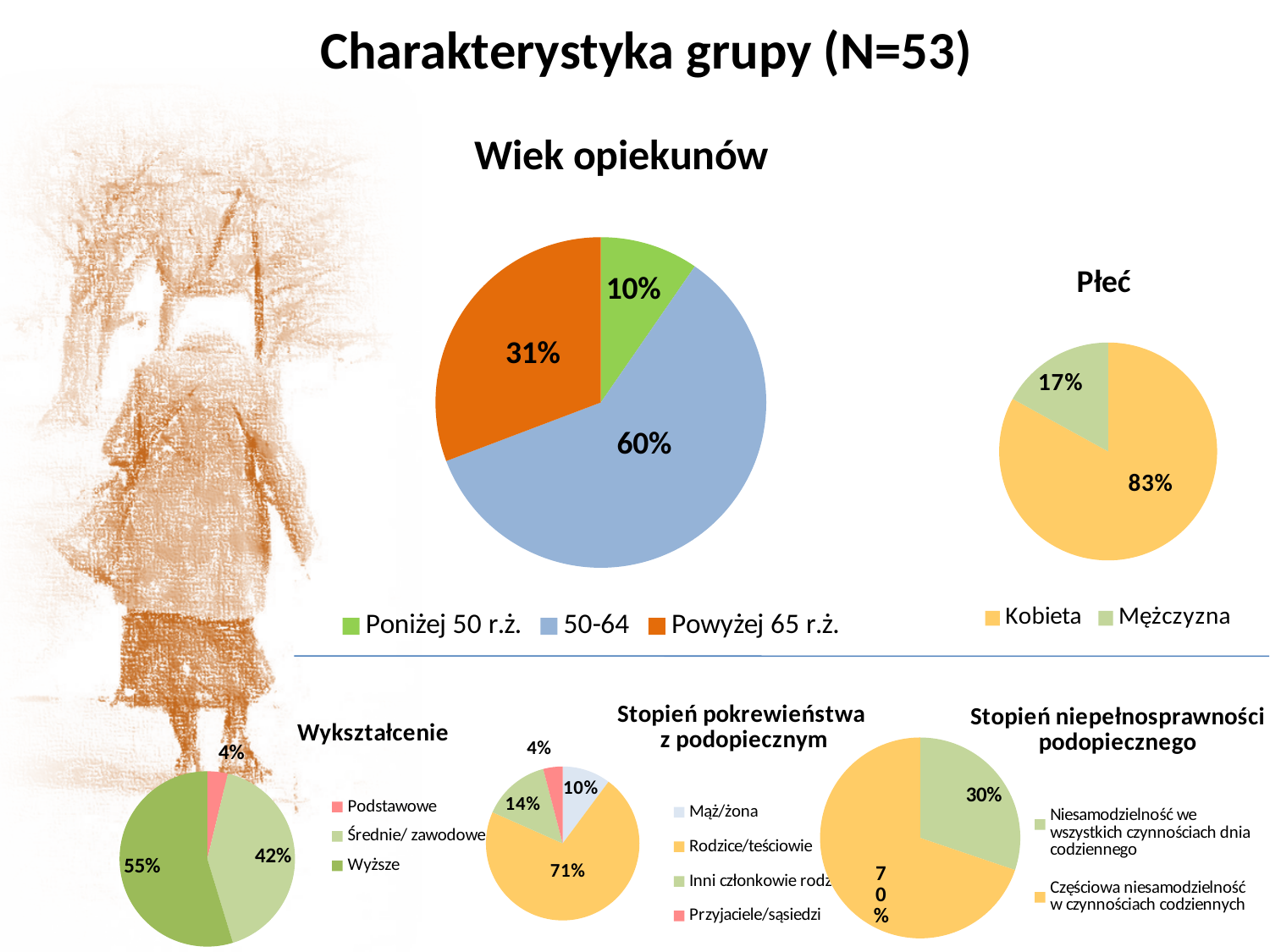
In the 'Stopień pokrewieństwa z podopiecznym' chart, what share is 'Rodzice/teściowie'? 71% In the 'Płeć' chart, what share is 'Kobieta'? 83% In the 'Wiek opiekunów' chart, which age group has the smallest share? Poniżej 50 r.ż. In the 'Wykształcenie' chart, which category has the largest share? Wyższe What type of chart is used for 'Płeć'? Pie chart In the 'Wiek opiekunów' chart, what share of caregivers are 'Powyżej 65 r.ż.'? 31% In the 'Stopień niepełnosprawności podopiecznego' chart, what share is 'Częściowa niesamodzielność w czynnościach codziennych'? 70% In the 'Płeć' chart, what is the difference between the 'Kobieta' and 'Mężczyzna' shares? 66% In the 'Wiek opiekunów' chart, how many categories does the legend list? 3 In the 'Wykształcenie' chart, what share is 'Wyższe'? 55% In the 'Wiek opiekunów' chart, what share of caregivers are in the 50-64 age group? 60% In the 'Stopień pokrewieństwa z podopiecznym' chart, which is larger: 'Mąż/żona' or 'Inni członkowie rodziny'? Inni członkowie rodziny